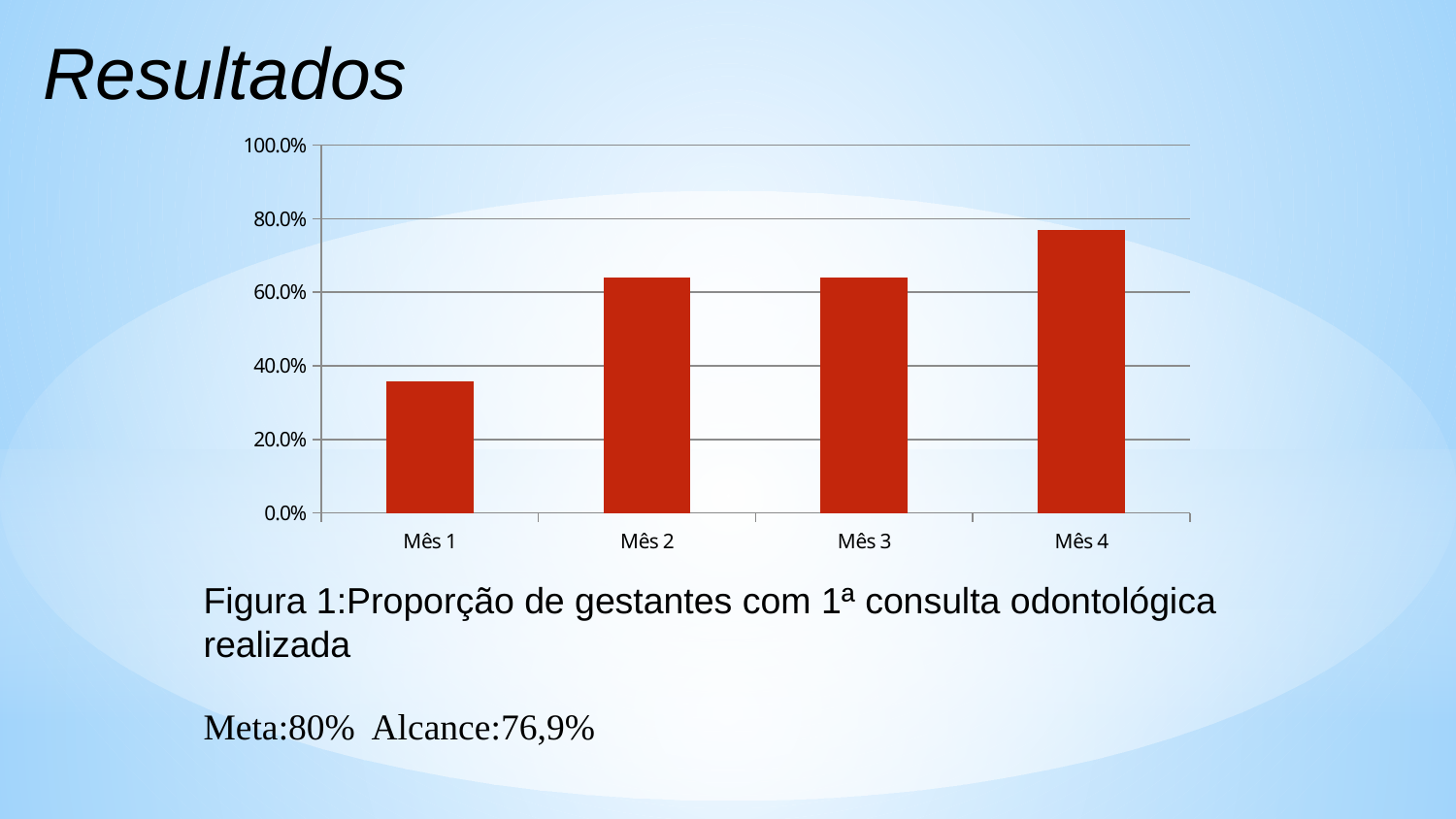
Is the value for Mês 4 greater or less than 60.0%? greater What is the figure caption given below the chart? Figura 1: Proporção de gestantes com 1ª consulta odontológica realizada Is the value for Mês 1 greater or less than 40.0%? less Which month has the highest bar? Mês 4 Is the value for Mês 2 greater or less than 80.0%? less Which is larger, the value for Mês 1 or the value for Mês 4? Mês 4 Which month has the lowest bar? Mês 1 What kind of chart is shown on the slide? bar chart Do the values generally rise or fall from Mês 1 to Mês 4? rise What colour are the bars in the chart? red How many categories (months) are plotted on the x axis? 4